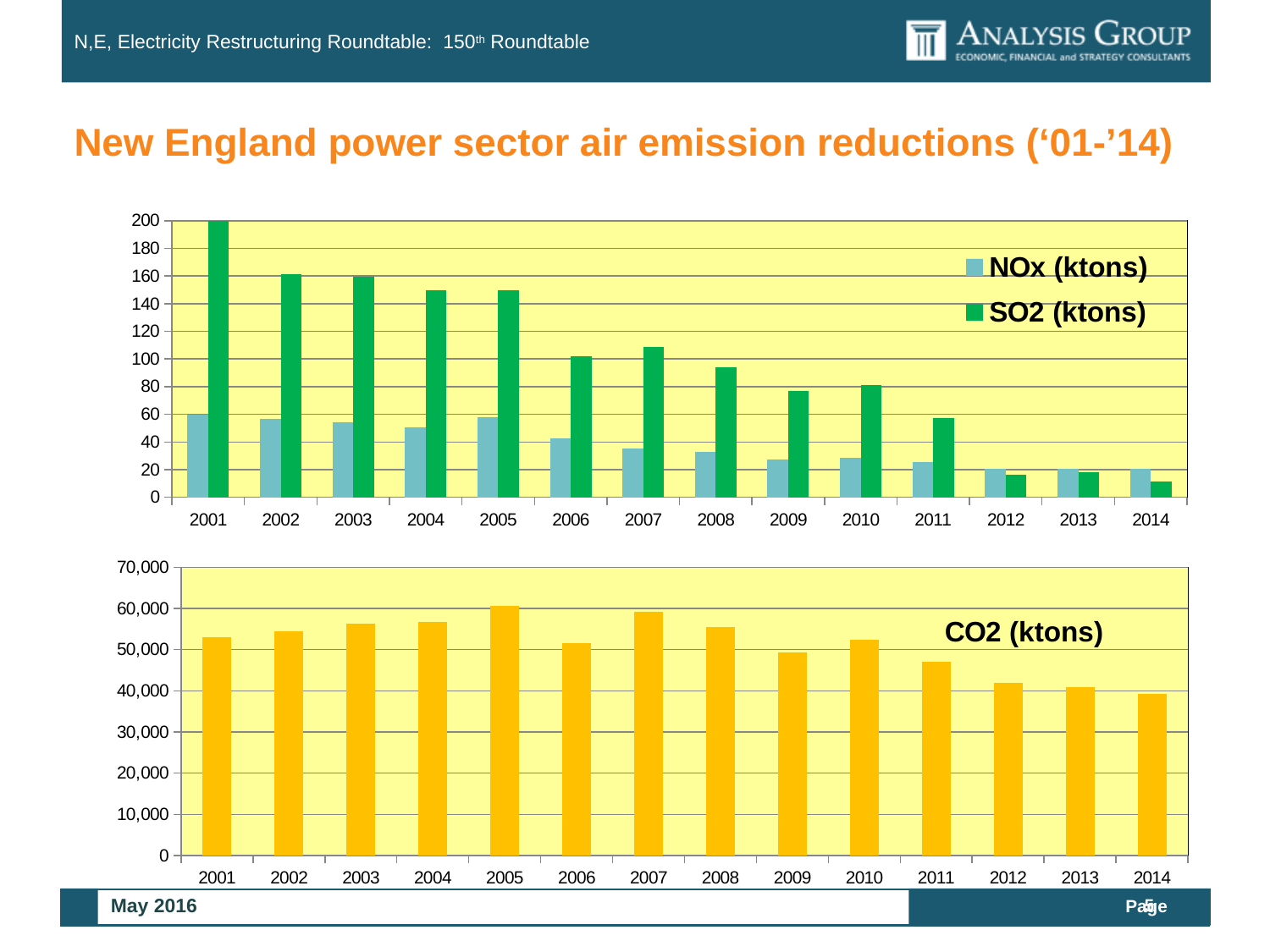
In the top chart, is the NOx (ktons) value for 2009 greater or less than 20? greater In the bottom CO2 (ktons) chart, which year has the highest value? 2005 In the top chart, which year has the highest SO2 (ktons) value? 2001 In the bottom CO2 (ktons) chart, which year has the lowest value? 2014 In the top chart, which is larger in 2014, NOx (ktons) or SO2 (ktons)? NOx (ktons) In the top chart, is the SO2 (ktons) value for 2002 greater or less than 140? greater In the bottom CO2 (ktons) chart, is the value for 2011 greater or less than 50,000? less How many series does the legend of the top chart list? 2 In the top chart, do SO2 (ktons) values generally rise or fall from 2001 to 2014? fall In the top chart, which year has the lowest SO2 (ktons) value? 2014 How many years are plotted in the bottom CO2 (ktons) chart? 14 In the top chart, which is larger in 2001, NOx (ktons) or SO2 (ktons)? SO2 (ktons)